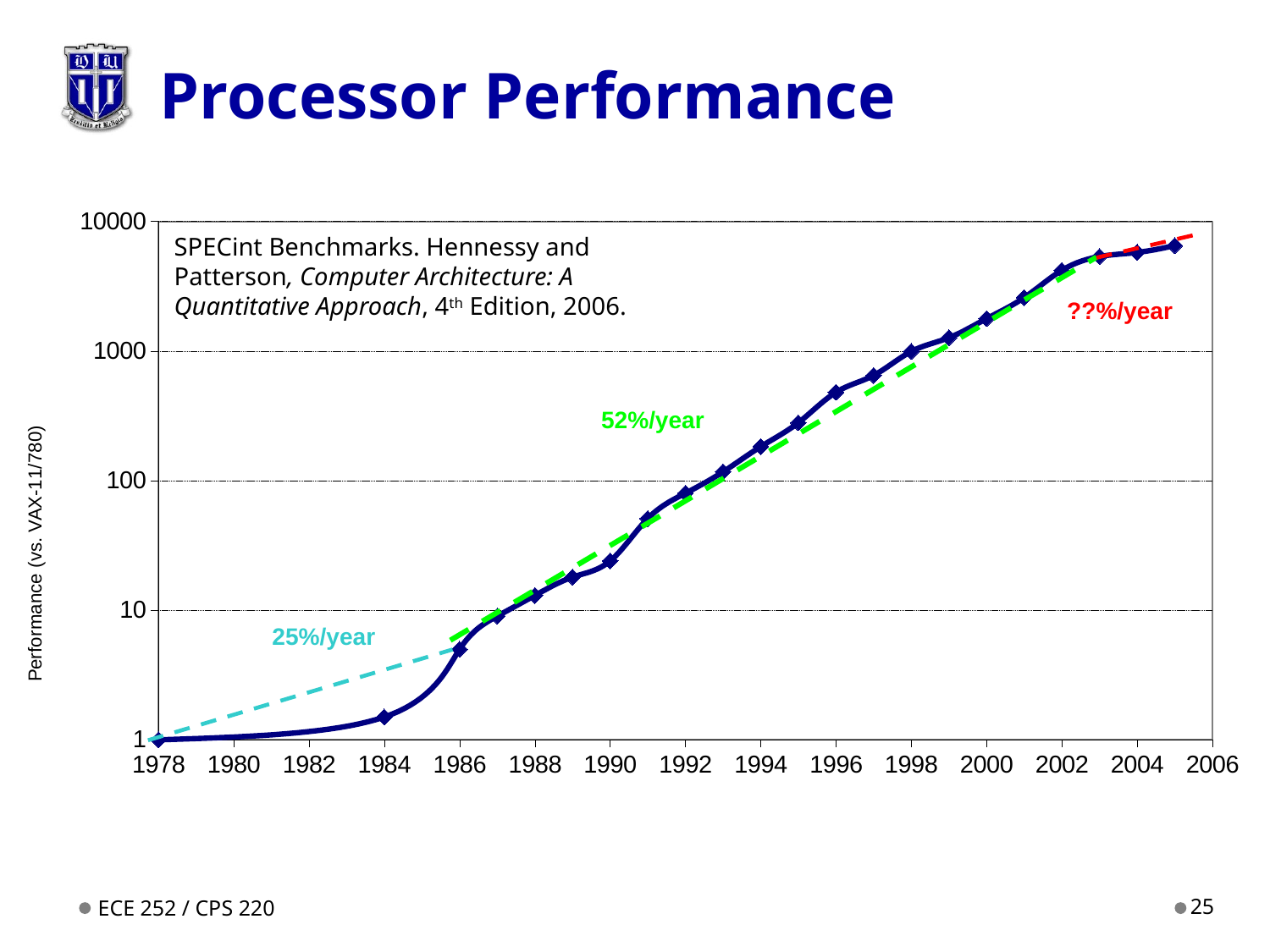
Is the performance value for 2005 greater or less than 10000? less Which year has the highest plotted performance value? 2005 Which year has the larger performance value, 1996 or 1988? 1996 Does processor performance rise or fall from 1978 to 2005 along the x axis? rise What is the label on the y axis of the chart? Performance (vs. VAX-11/780) Is the performance value for 1994 greater or less than 100? greater What kind of chart is shown on the slide? line chart Is the performance value for 1990 greater or less than 10? greater Which year has the lowest plotted performance value? 1978 What annual growth rate is annotated on the chart for the period around 1986 to 2002? 52%/year